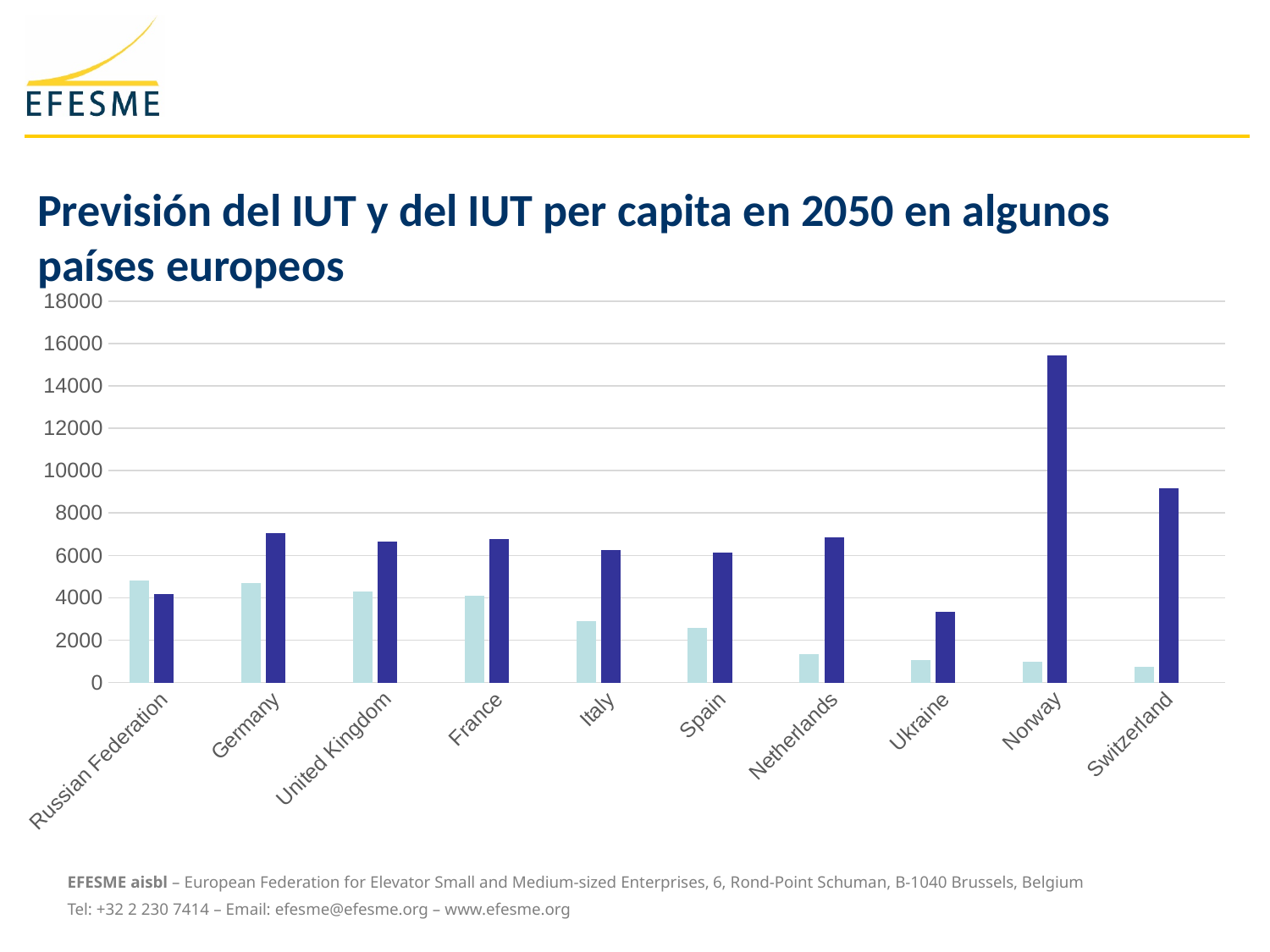
Which country has the tallest dark blue bar? Norway How many countries are shown on the x axis of the chart? 10 Which is larger for the Russian Federation, the light blue bar or the dark blue bar? the light blue bar Which country has the shortest dark blue bar? Ukraine Which country has the shortest light blue bar? Switzerland Is the light blue bar for Switzerland greater or less than 2000? less Is the dark blue bar for Norway greater or less than 14000? greater Is the dark blue bar for Ukraine greater or less than 4000? less What kind of chart is shown on the slide? bar chart Do the light blue bars generally rise or fall from left to right across the countries? fall What is the title of the slide containing the chart? Previsión del IUT y del IUT per capita en 2050 en algunos países europeos